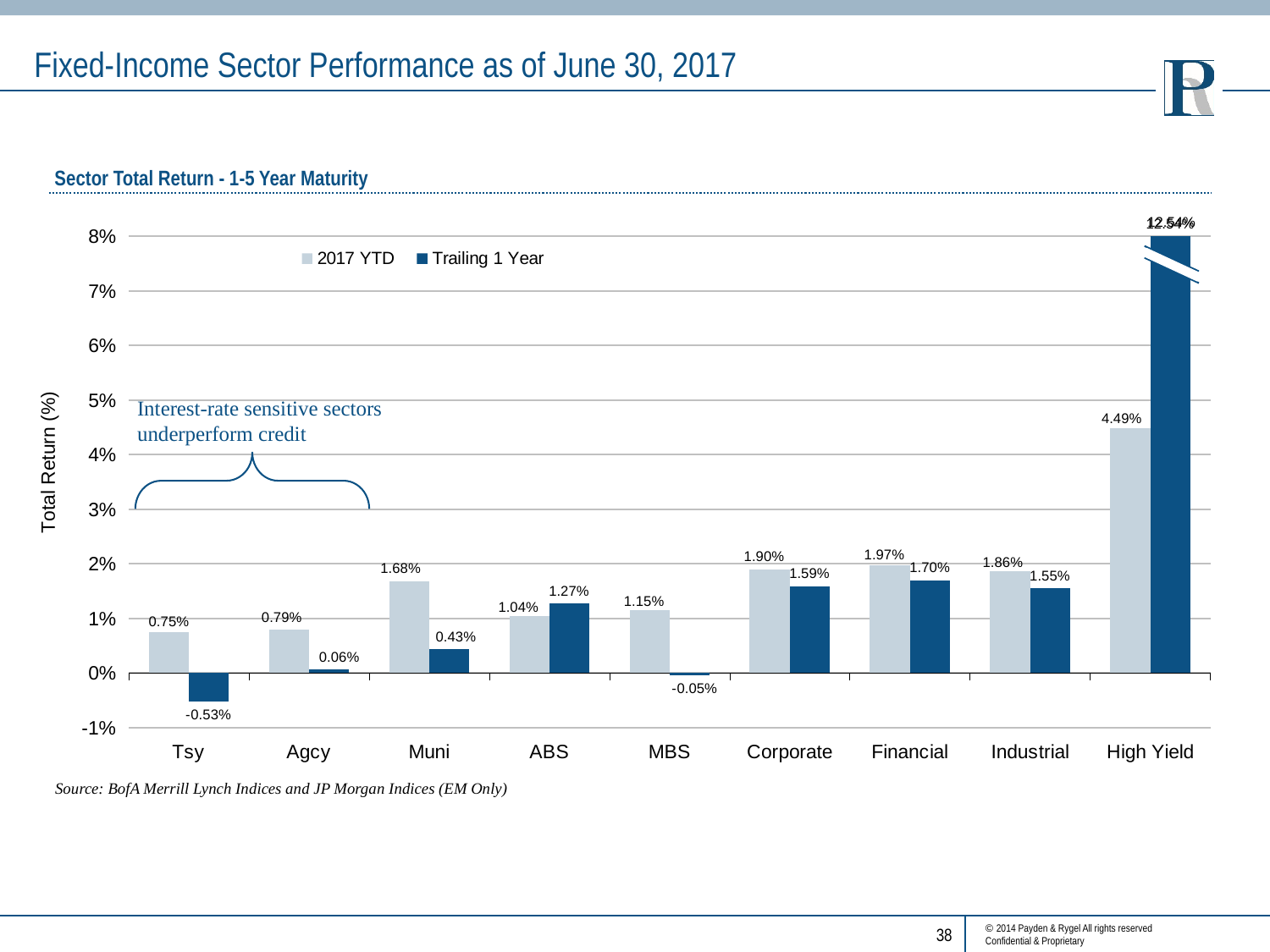
What is the Trailing 1 Year total return for MBS? -0.05% What is the 2017 YTD total return for Muni? 1.68% For ABS, which is larger: the 2017 YTD return or the Trailing 1 Year return? Trailing 1 Year What type of chart is shown on the slide? Bar chart How many series does the legend list? 2 What is the difference between the 2017 YTD and Trailing 1 Year returns for Financial? 0.27% How many sectors are shown on the x axis? 9 Which sector has the highest 2017 YTD total return? High Yield Which sector has the lowest Trailing 1 Year total return? Tsy What is the Trailing 1 Year total return for Tsy? -0.53% What is the title of the chart? Sector Total Return - 1-5 Year Maturity Is the 2017 YTD value for High Yield greater or less than 4%? greater